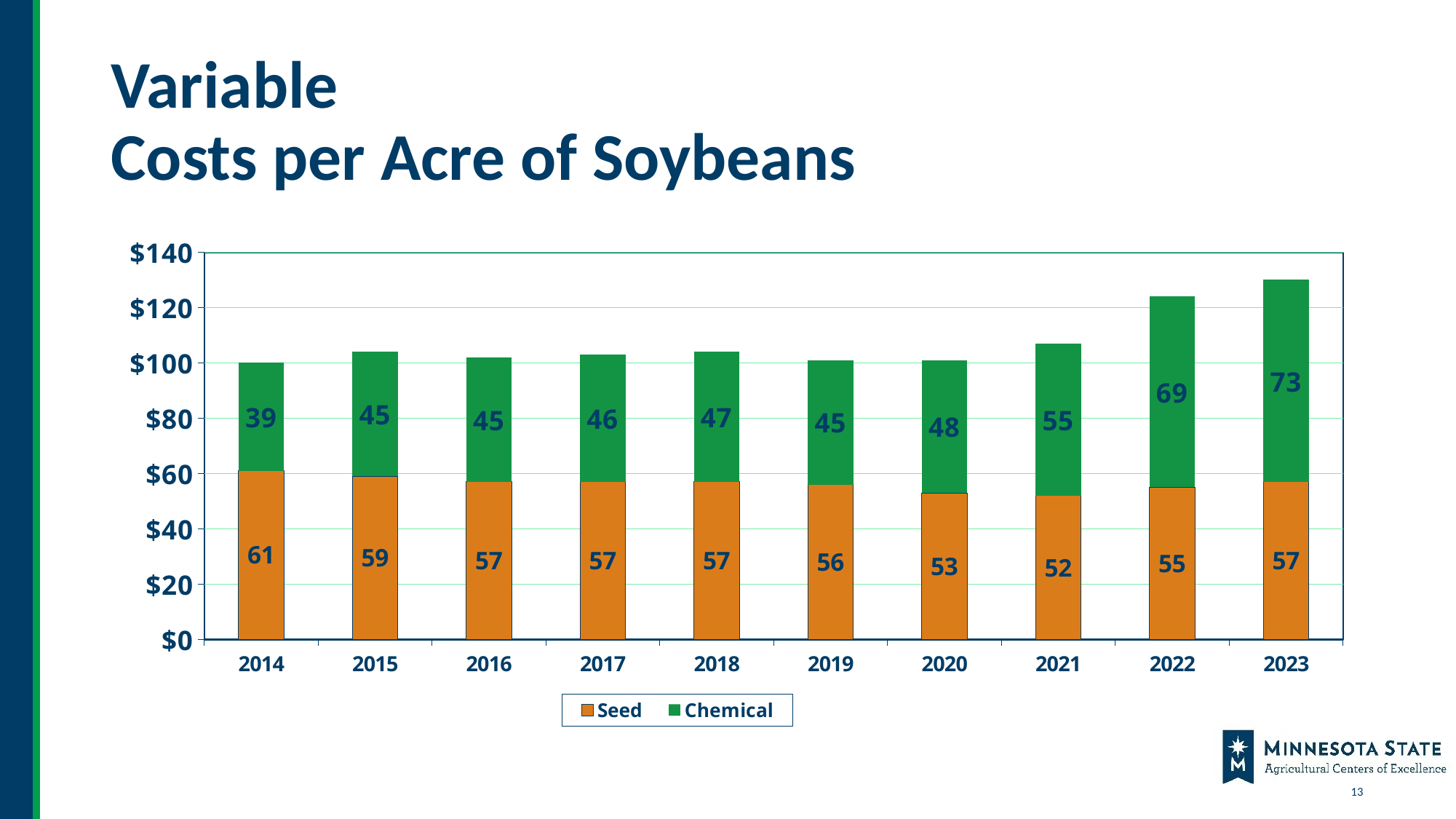
Is the total variable cost for 2023 greater or less than $120? greater How many series does the legend list? 2 What kind of chart is shown on the slide? Stacked bar chart Which is larger, the Seed cost in 2015 or the Seed cost in 2022? Seed cost in 2015 What is the Seed cost per acre in 2014? 61 What is the Chemical cost per acre in 2020? 48 What is the difference between the Chemical cost in 2023 and in 2014? 34 What is the Chemical cost per acre in 2023? 73 Which year has the lowest Seed cost? 2021 How many years are shown on the x axis? 10 What is the total of the stacked bar for 2022? 124 Which year has the highest Chemical cost? 2023